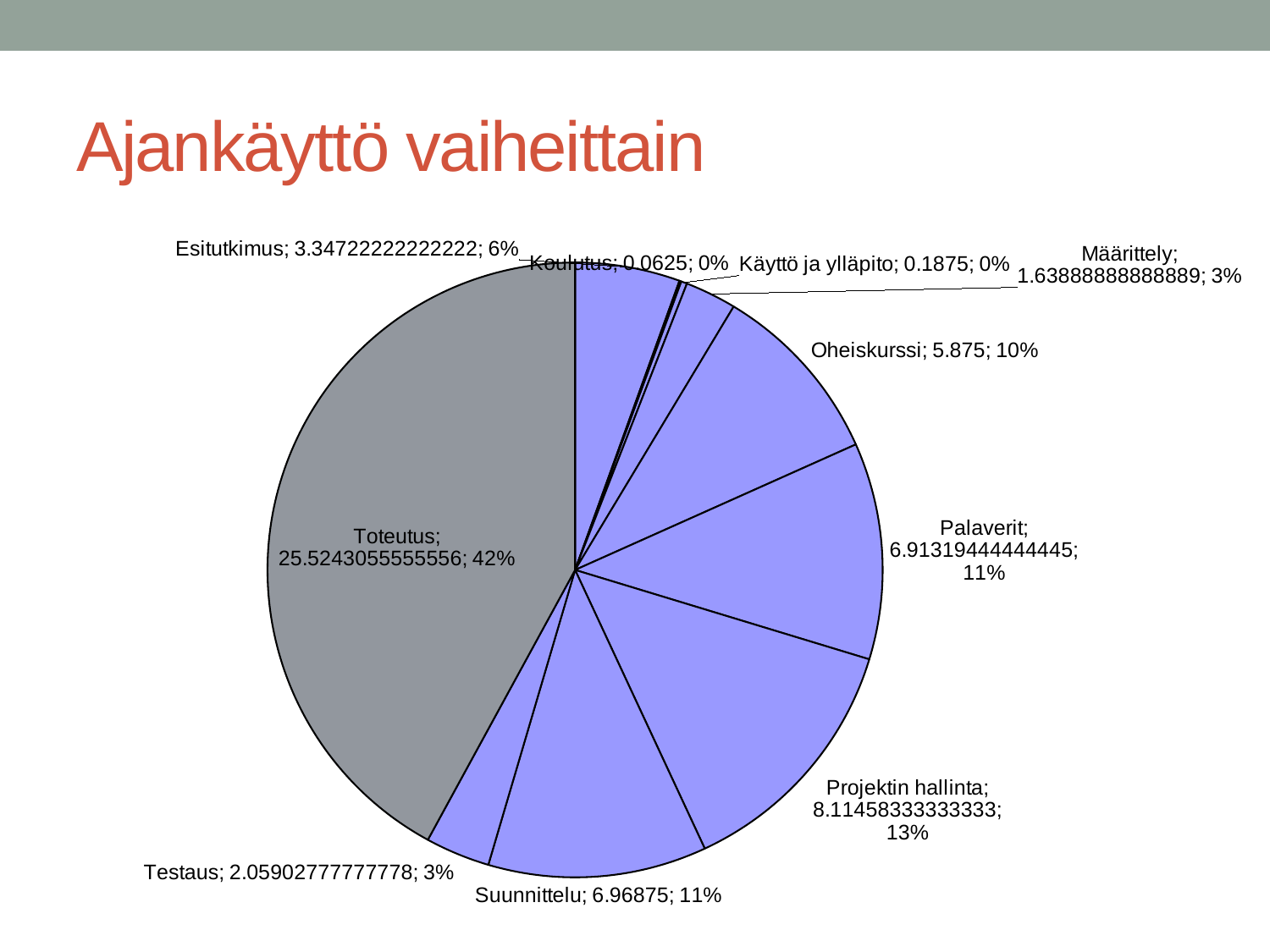
What percentage share does Projektin hallinta have? 13% What type of chart is shown on the slide? pie chart What percentage share does Esitutkimus have? 6% How many slices does the pie chart have? 10 Which is larger, the value for Projektin hallinta or the value for Oheiskurssi? Projektin hallinta What is the title of the chart on the slide? Ajankäyttö vaiheittain What percentage share does Toteutus have in the pie chart? 42% What value is shown for Oheiskurssi? 5.875 What is the value shown for Käyttö ja ylläpito? 0.1875 Which category has the largest slice of the pie? Toteutus What value is shown for Toteutus? 25.5243055555556 Which category has the smallest value in the pie chart? Koulutus